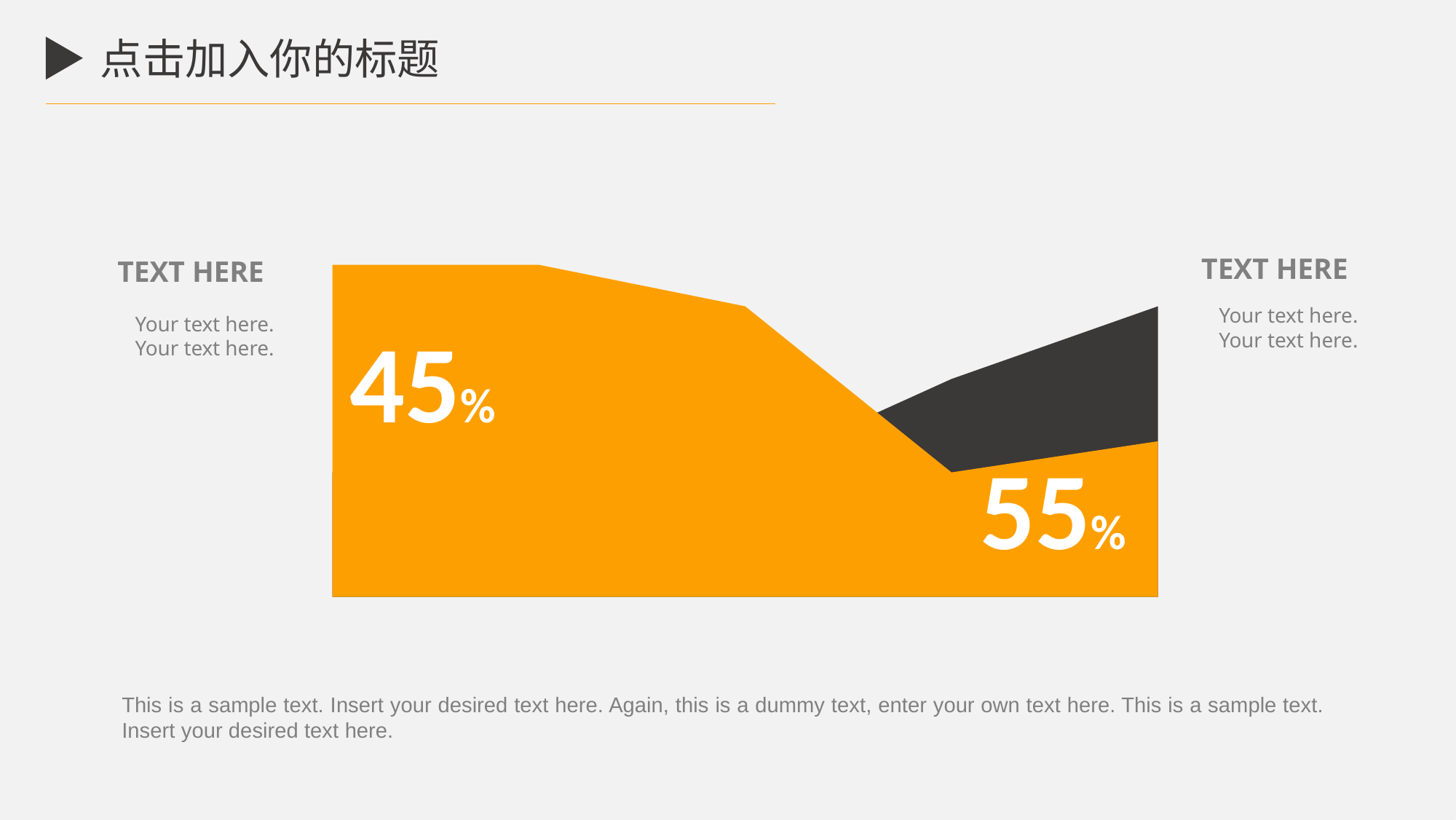
Does the dark gray area rise or fall toward the right edge of the chart? rise What percentage value is printed on the right side of the orange area? 55% Does the top edge of the orange area rise or fall from left to right? fall What colour is the area that carries the 45% and 55% labels? orange Which of the two printed values is larger, 45% or 55%? 55% What colour is the second area that appears on the right side of the chart? dark gray What percentage value is printed on the left side of the orange area? 45% What kind of chart is shown on the slide? area chart What is the difference between the two printed percentage values, 55% and 45%? 10% How many percentage values are printed on the chart? 2